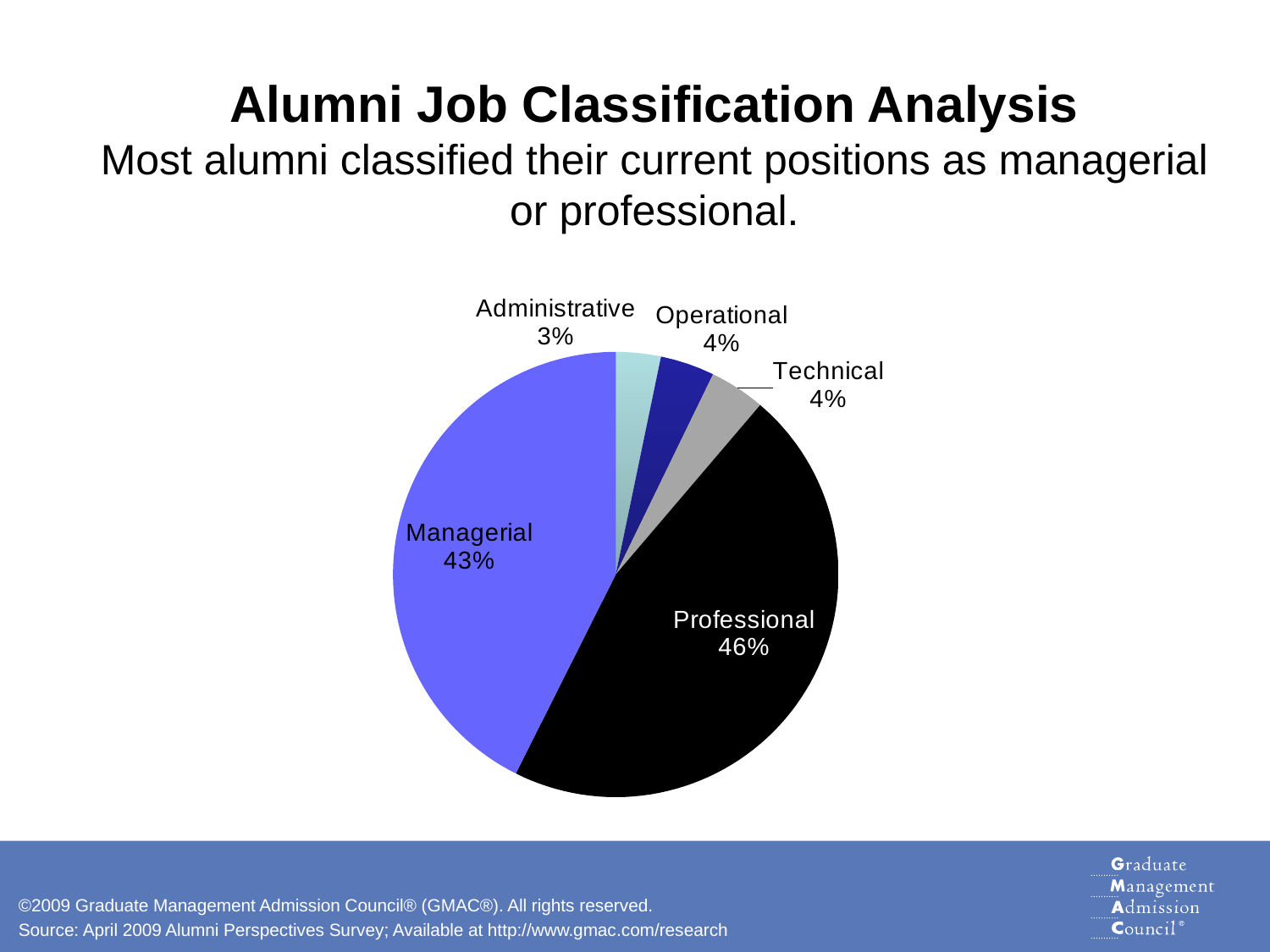
What percentage of alumni classified their current position as Professional? 46% How many job classification categories are shown in the pie chart? 5 What percentage of alumni classified their current position as Managerial? 43% What share of the pie is labelled Administrative? 3% What is the difference in percentage points between the Professional and Managerial slices? 3 Which job classification has the largest share of the pie? Professional Which is larger, the Technical slice or the Administrative slice? Technical What percentage is shown for the Operational slice? 4% What is the combined share of the Managerial and Professional slices? 89% What kind of chart is shown on the slide? Pie chart What is the title of the chart on the slide? Alumni Job Classification Analysis Which job classification has the smallest share of the pie? Administrative